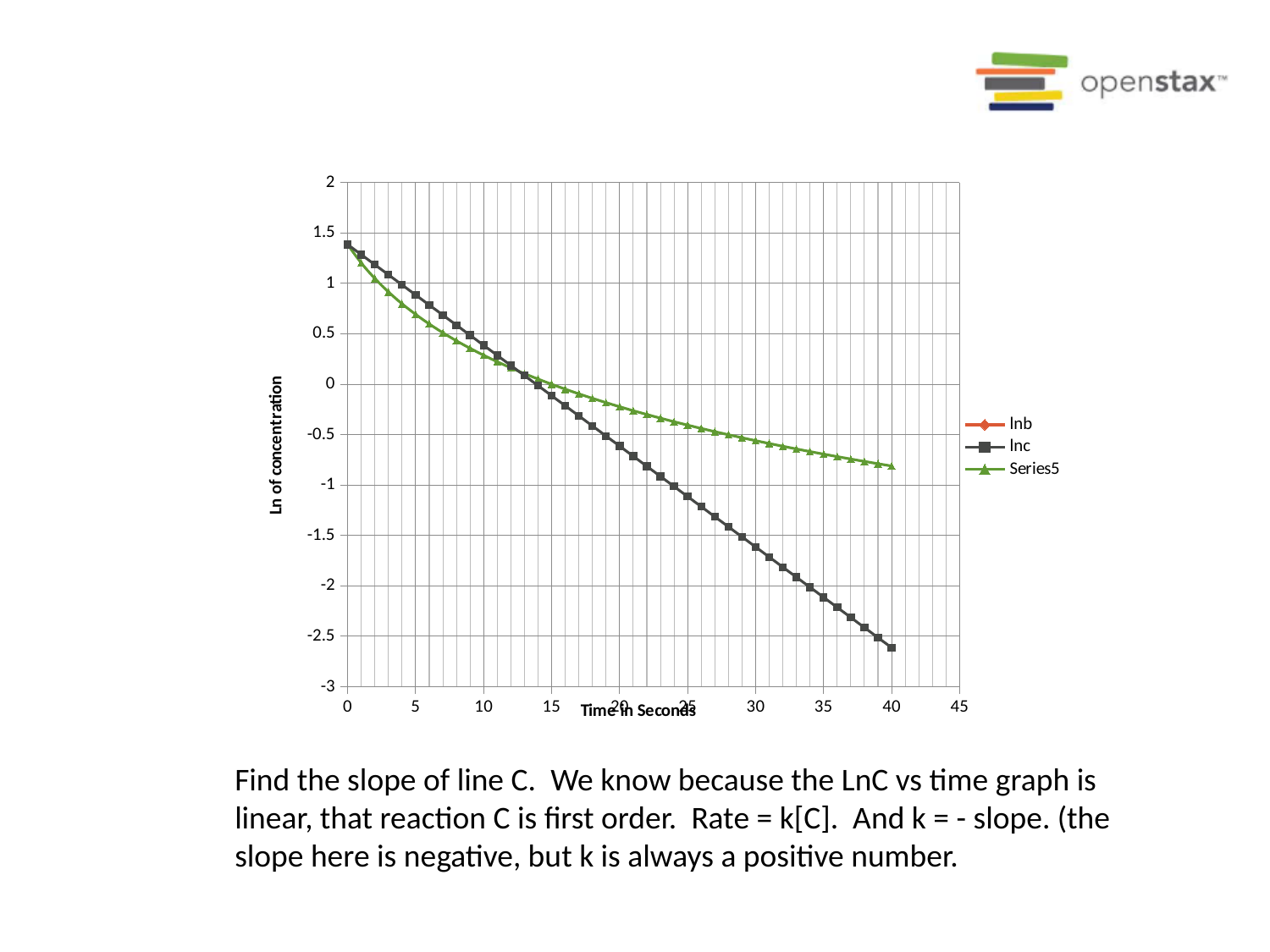
Is the value of Series5 at 30 seconds greater or less than -1? greater How many series does the chart's legend list? 3 Does the lnc series rise or fall as time increases? fall Does the Series5 line rise or fall as time increases? fall Is the value of Series5 at 10 seconds greater or less than 0? greater At 5 seconds, which series has the higher value, lnc or Series5? lnc At 40 seconds, which series has the higher value, lnc or Series5? Series5 What kind of chart is shown on the slide? line chart Is the value of lnc at 30 seconds greater or less than -1? less What is the title of the y axis? Ln of concentration What are the names of the series listed in the legend? lnb, lnc, Series5